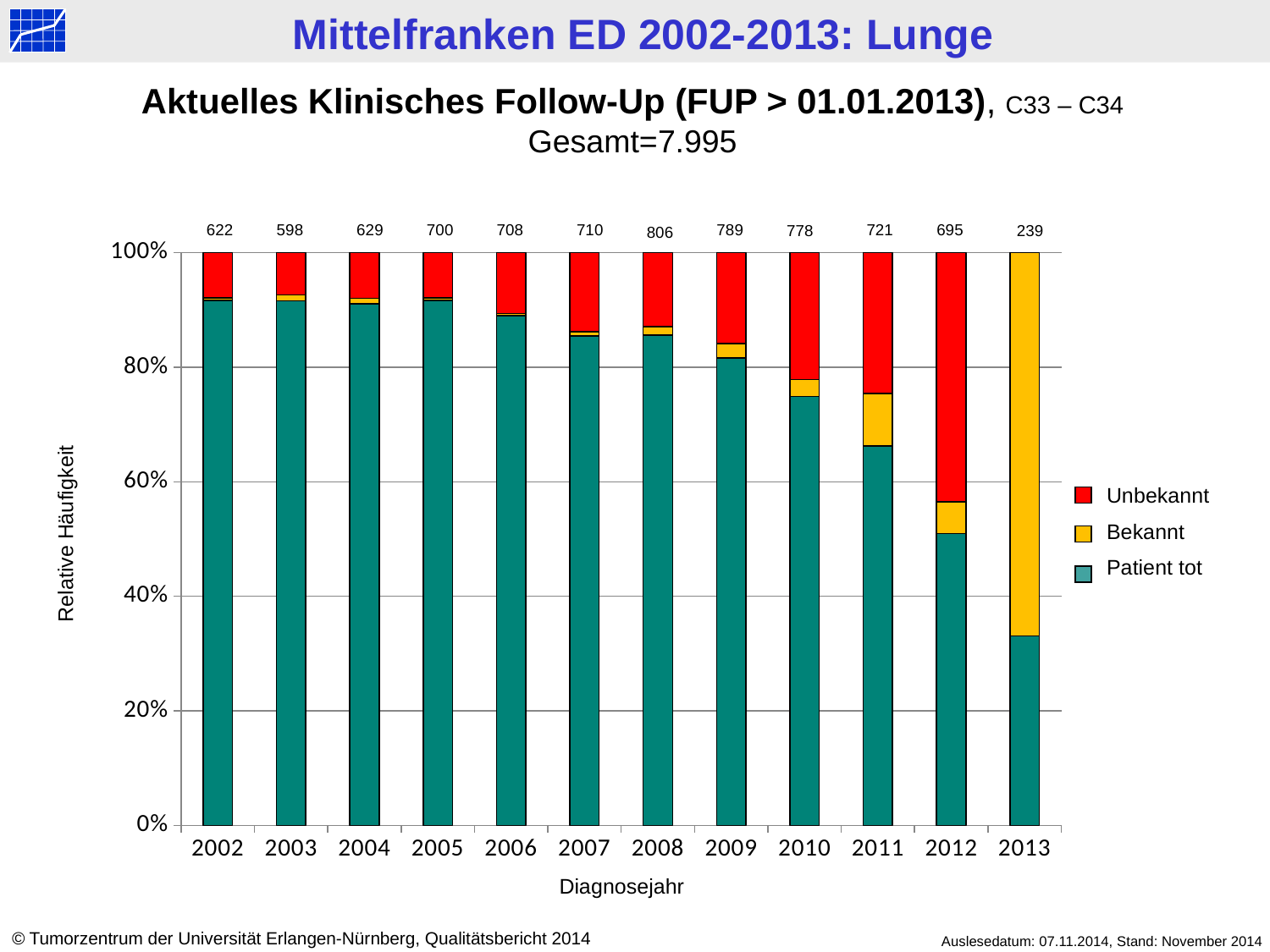
Which has the larger number printed above its bar, 2003 or 2004? 2004 Which diagnosis year has the lowest number printed above its bar? 2013 What is the difference between the numbers printed above the bars for 2008 and 2013? 567 Does the 'Patient tot' share rise or fall from 2002 to 2013? fall Is the 'Patient tot' share for 2002 greater or less than 80%? greater What number is printed above the bar for 2008? 806 How many series does the legend list? 3 How many diagnosis years are shown on the x axis? 12 What number is printed above the bar for 2005? 700 Which diagnosis year has the highest number printed above its bar? 2008 What number is printed above the bar for 2013? 239 Is the 'Patient tot' share for 2013 greater or less than 40%? less